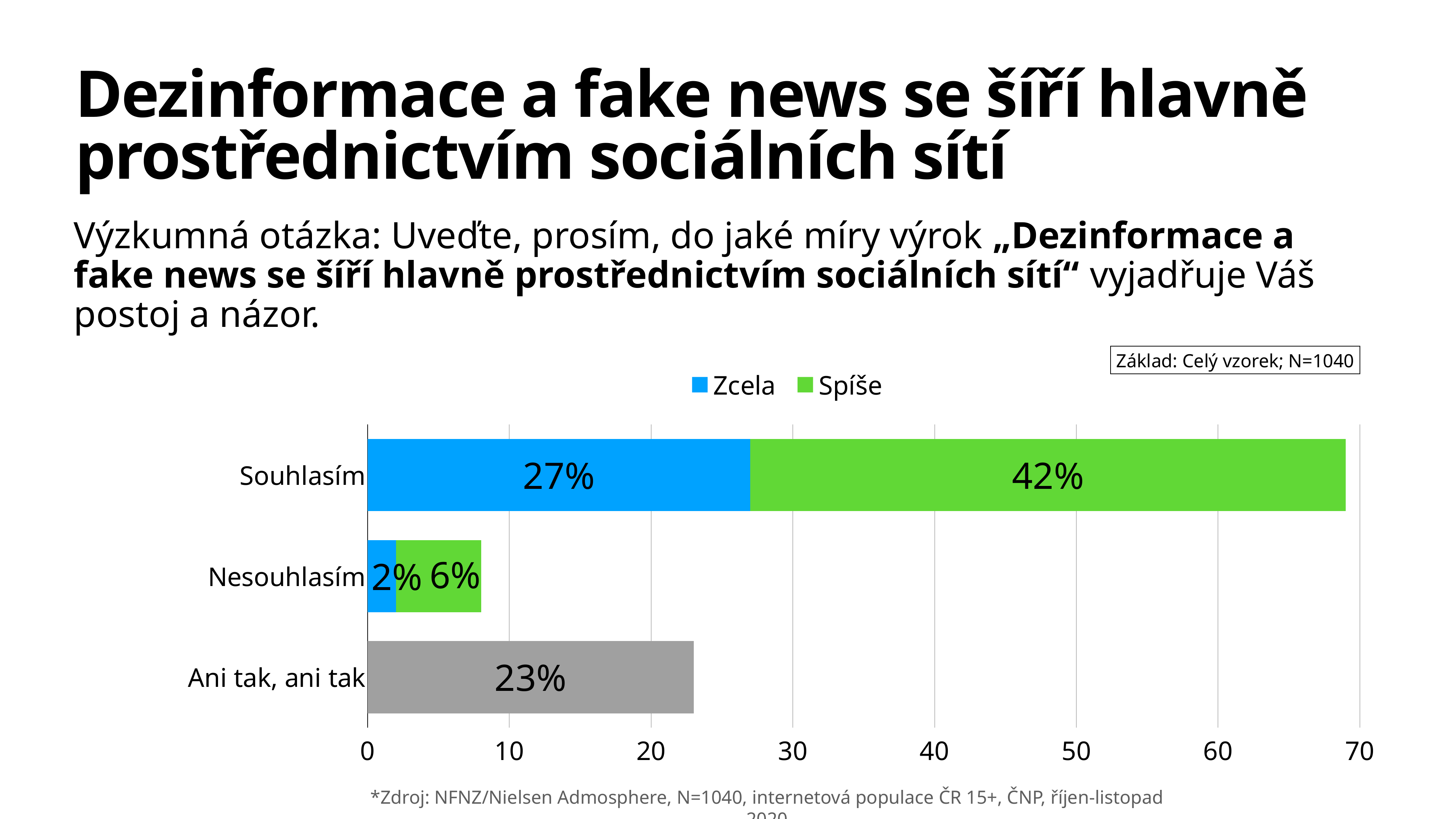
How many series does the legend list? 2 What is the 'Spíše' value for Souhlasím? 42% What is the total of the stacked bar for Souhlasím? 69% What is the difference between the 'Spíše' and 'Zcela' values for Souhlasím? 15% What kind of chart is shown on the slide? Bar chart Which is larger: the 'Spíše' value for Nesouhlasím or the 'Zcela' value for Nesouhlasím? Spíše What is the 'Spíše' value for Nesouhlasím? 6% What is the 'Zcela' value for Nesouhlasím? 2% What is the total of the stacked bar for Nesouhlasím? 8% What is the 'Zcela' value for Souhlasím? 27% How many categories are shown on the vertical axis? 3 What is the value shown for 'Ani tak, ani tak'? 23%